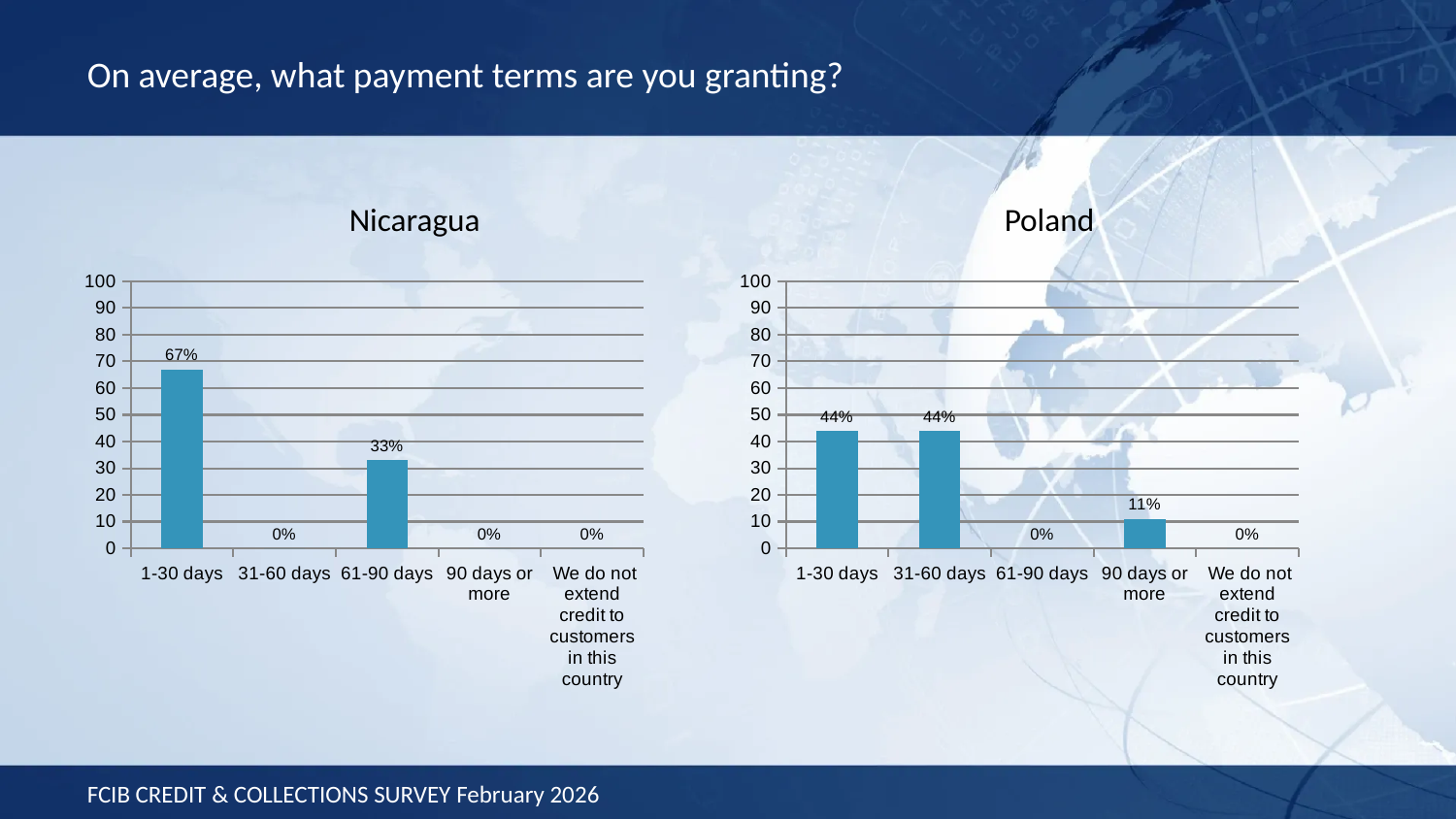
What kind of chart is the Nicaragua chart? bar chart In the Nicaragua chart, is the value for 1-30 days greater or less than 60? greater Which is larger: the value for 1-30 days in the Nicaragua chart or the value for 1-30 days in the Poland chart? Nicaragua In the Poland chart, which category has the lowest non-zero value? 90 days or more In the Nicaragua chart, what is the difference between the values for 1-30 days and 61-90 days? 34% In the Nicaragua chart, which category has the highest value? 1-30 days In the Poland chart, what is the difference between the values for 1-30 days and 90 days or more? 33% In the Nicaragua chart, what is the value for 61-90 days? 33% In the Poland chart, what is the value for 31-60 days? 44% In the Poland chart, what is the value for 90 days or more? 11% How many categories are shown on the x axis of the Poland chart? 5 In the Nicaragua chart, what is the value for 1-30 days? 67%